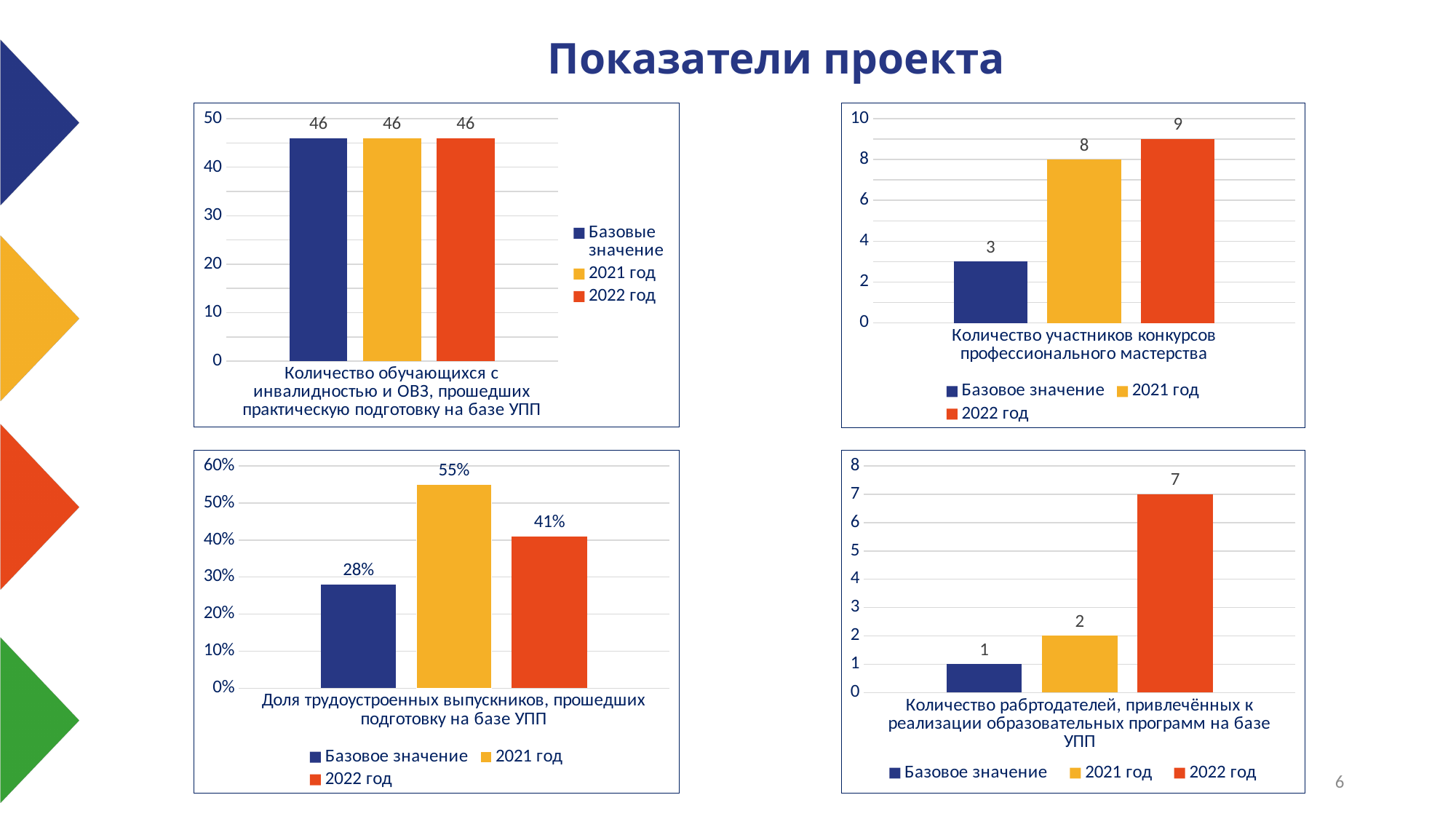
In the bottom-left chart (Доля трудоустроенных выпускников), what is the value for 2021 год? 55% In the bottom-right chart, is the value for 2022 год greater or less than 5? greater In the bottom-right chart, what is the difference between the 2022 год value and the 2021 год value? 5 In the top-right chart (Количество участников конкурсов профессионального мастерства), what is the value for 2021 год? 8 In the top-right chart, which series has the highest value? 2022 год What type of chart is the bottom-left chart? bar chart In the top-right chart, what is the difference between the 2022 год value and the Базовое значение? 6 In the top-left chart, what is the value for 2022 год? 46 In the bottom-left chart, is the value for 2021 год larger or smaller than the value for 2022 год? larger In the bottom-right chart (Количество работодателей), what is the value for 2022 год? 7 How many series does the legend of the top-left chart list? 3 In the bottom-left chart, which series has the lowest value? Базовое значение